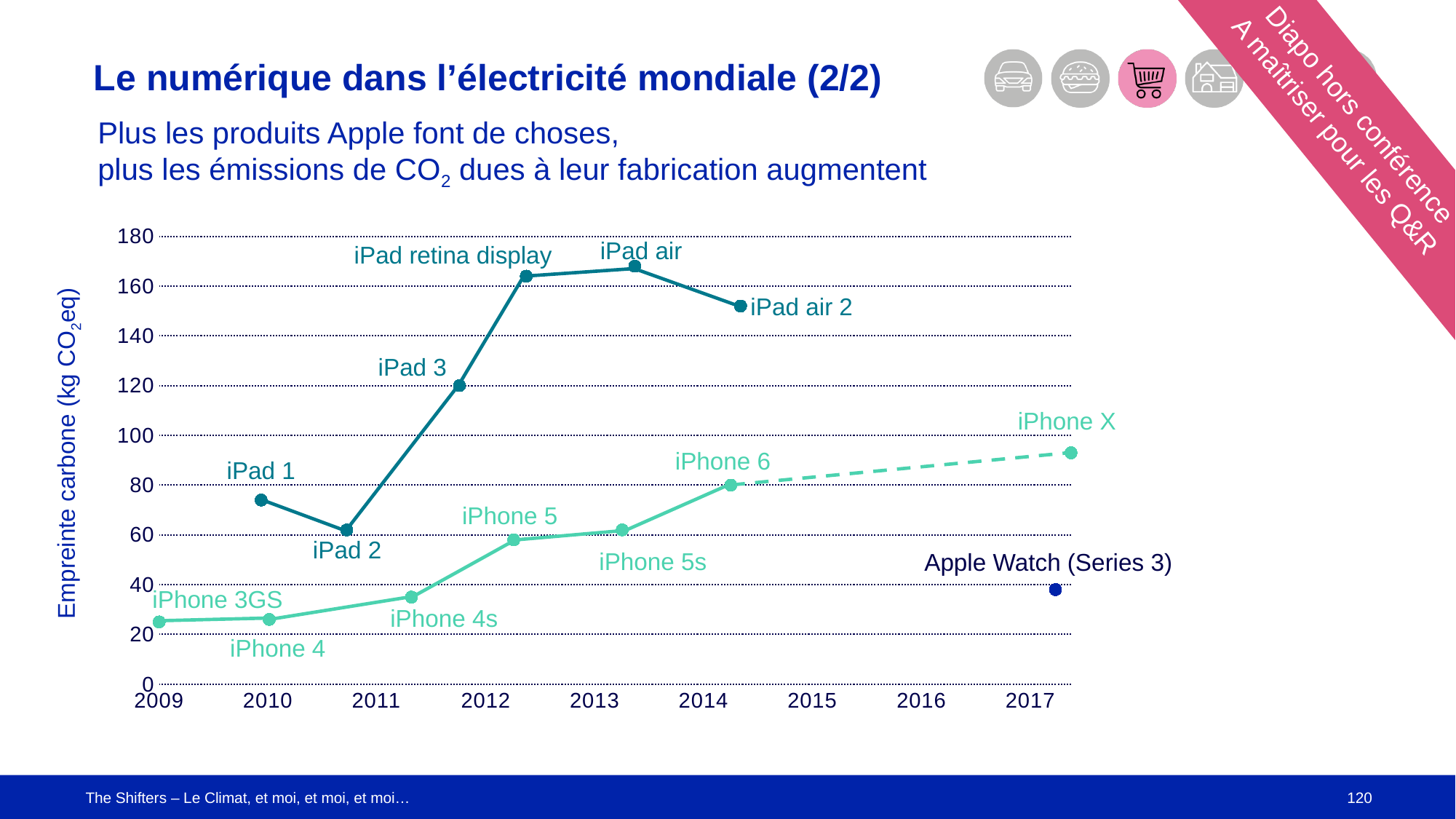
Is the value for iPhone X greater or less than 80? greater Is the value for iPad 3 greater or less than 100? greater Is the value for iPad 1 greater or less than 60? greater What kind of chart is shown on the slide? line chart Which has a higher carbon footprint, iPad 3 or iPhone 5? iPad 3 How many iPhone models are plotted on the chart? 7 Does the carbon footprint of iPhone models rise or fall from iPhone 3GS to iPhone X? rise What is the label of the vertical axis? Empreinte carbone (kg CO2eq) Which has a higher carbon footprint, iPad air 2 or iPhone X? iPad air 2